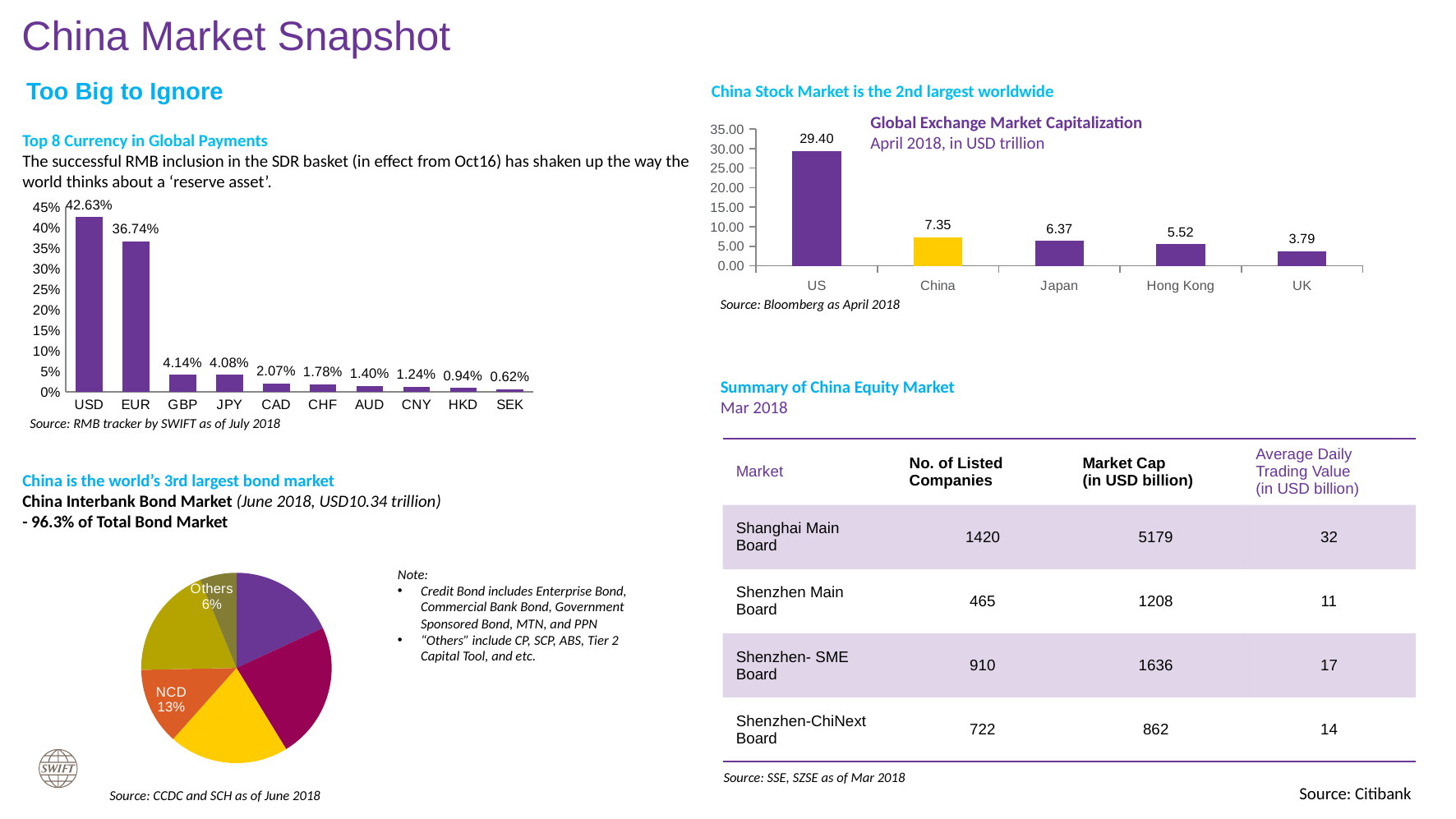
In the Top 8 Currency in Global Payments chart, what is the value for USD? 42.63% In the Top 8 Currency in Global Payments chart, how many currencies are plotted? 10 In the Top 8 Currency in Global Payments chart, what is the difference between the USD and EUR values? 5.89% In the China Interbank Bond Market pie chart, what share does NCD have? 13% In the Top 8 Currency in Global Payments chart, what is the value for CNY? 1.24% In the Top 8 Currency in Global Payments chart, do the values rise or fall from left to right along the x axis? fall In the Global Exchange Market Capitalization chart, what is the difference between the US and China values? 22.05 In the Global Exchange Market Capitalization chart, what is the value for China? 7.35 What kind of chart is the Global Exchange Market Capitalization chart? bar chart In the Global Exchange Market Capitalization chart, which is larger, Japan or Hong Kong? Japan In the Global Exchange Market Capitalization chart, which country has the highest market capitalization? US In the Top 8 Currency in Global Payments chart, which currency has the lowest value? SEK